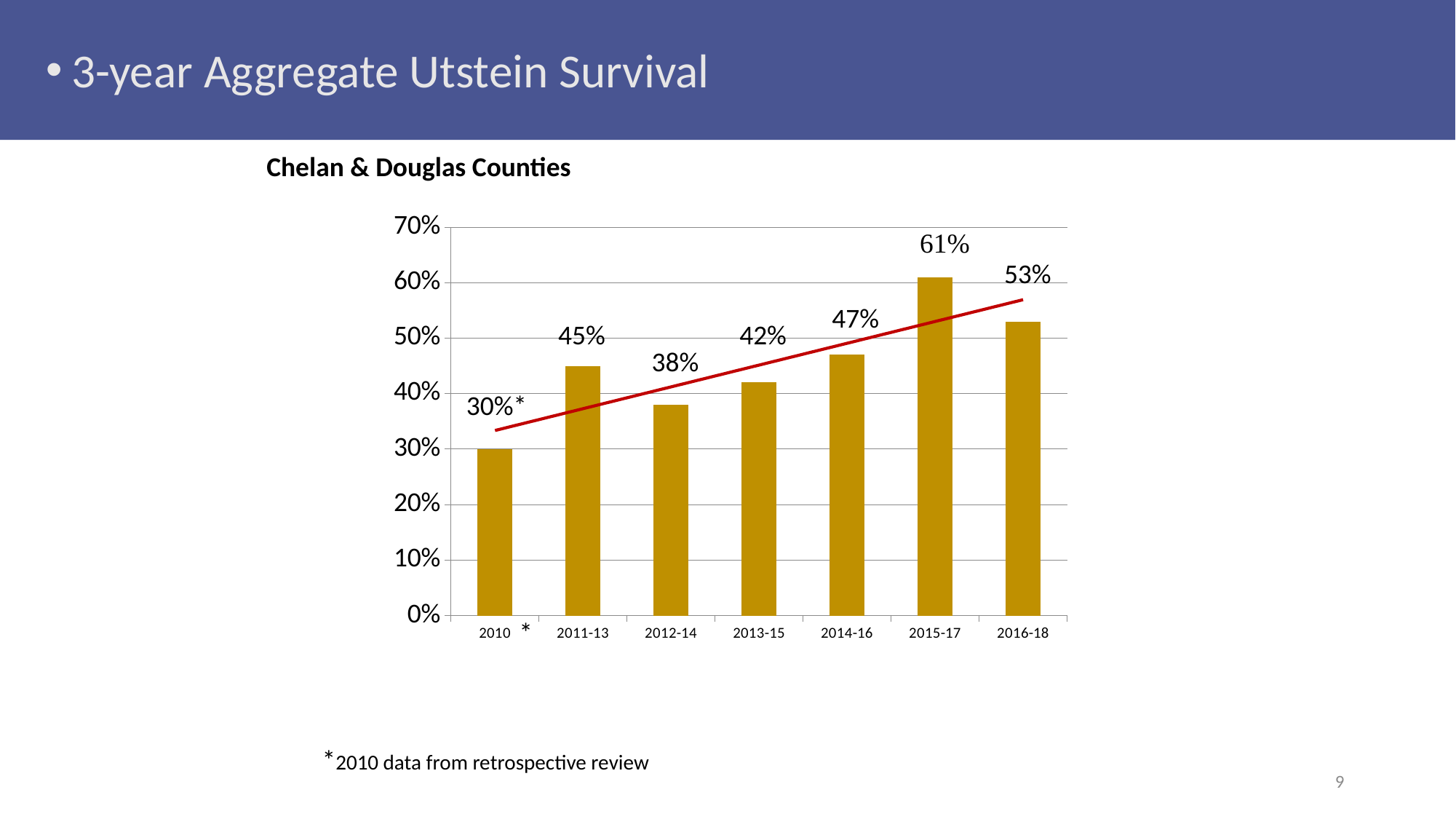
Which period has the highest survival value? 2015-17 What is the survival value for 2015-17? 61% How many periods are shown on the x axis? 7 Which is larger, the value for 2011-13 or the value for 2012-14? 2011-13 What is the survival value for 2016-18? 53% What is the difference between the survival values for 2015-17 and 2016-18? 8% What is the overall trend of the survival values from 2010 to 2015-17? rising What kind of chart is shown on the slide? bar chart Is the value for 2014-16 greater or less than 40%? greater What is the title shown above the chart? Chelan & Douglas Counties Which period has the lowest survival value? 2010 What is the survival value for 2012-14? 38%